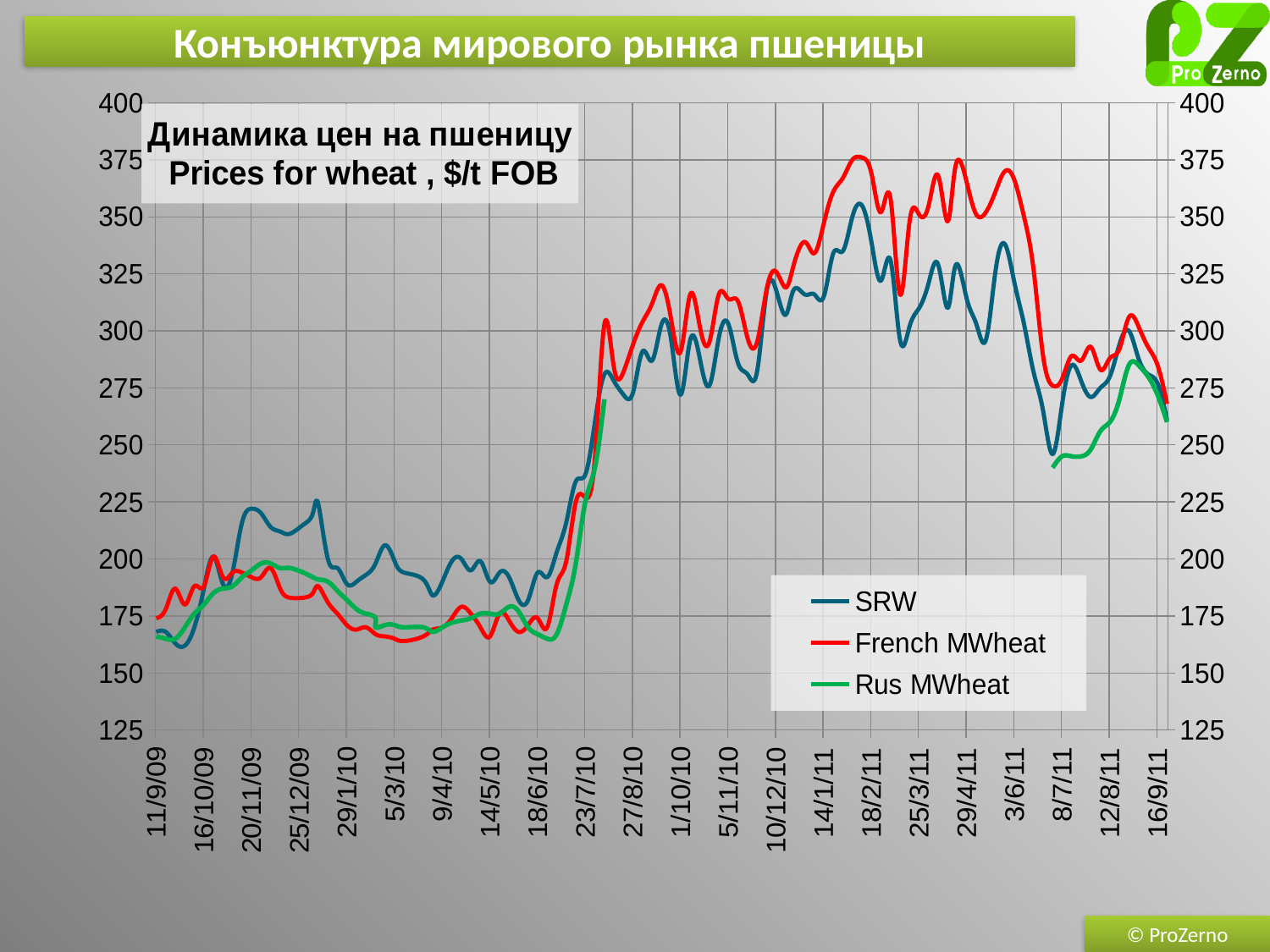
Is the value for SRW at 11/9/09 greater or less than 175? less Is the value for Rus MWheat at 8/7/11 greater or less than 250? less Which series are listed in the legend? SRW, French MWheat, Rus MWheat What is the English part of the chart title? Prices for wheat , $/t FOB Is the highest value of French MWheat greater or less than 350? greater How many series does the legend list? 3 At 20/11/09, which is larger: SRW or French MWheat? SRW What kind of chart is shown on the slide? line chart Does the SRW series rise or fall between 18/6/10 and 27/8/10? rise Which series reaches the highest value on the chart? French MWheat At 8/7/11, which is larger: SRW or French MWheat? French MWheat